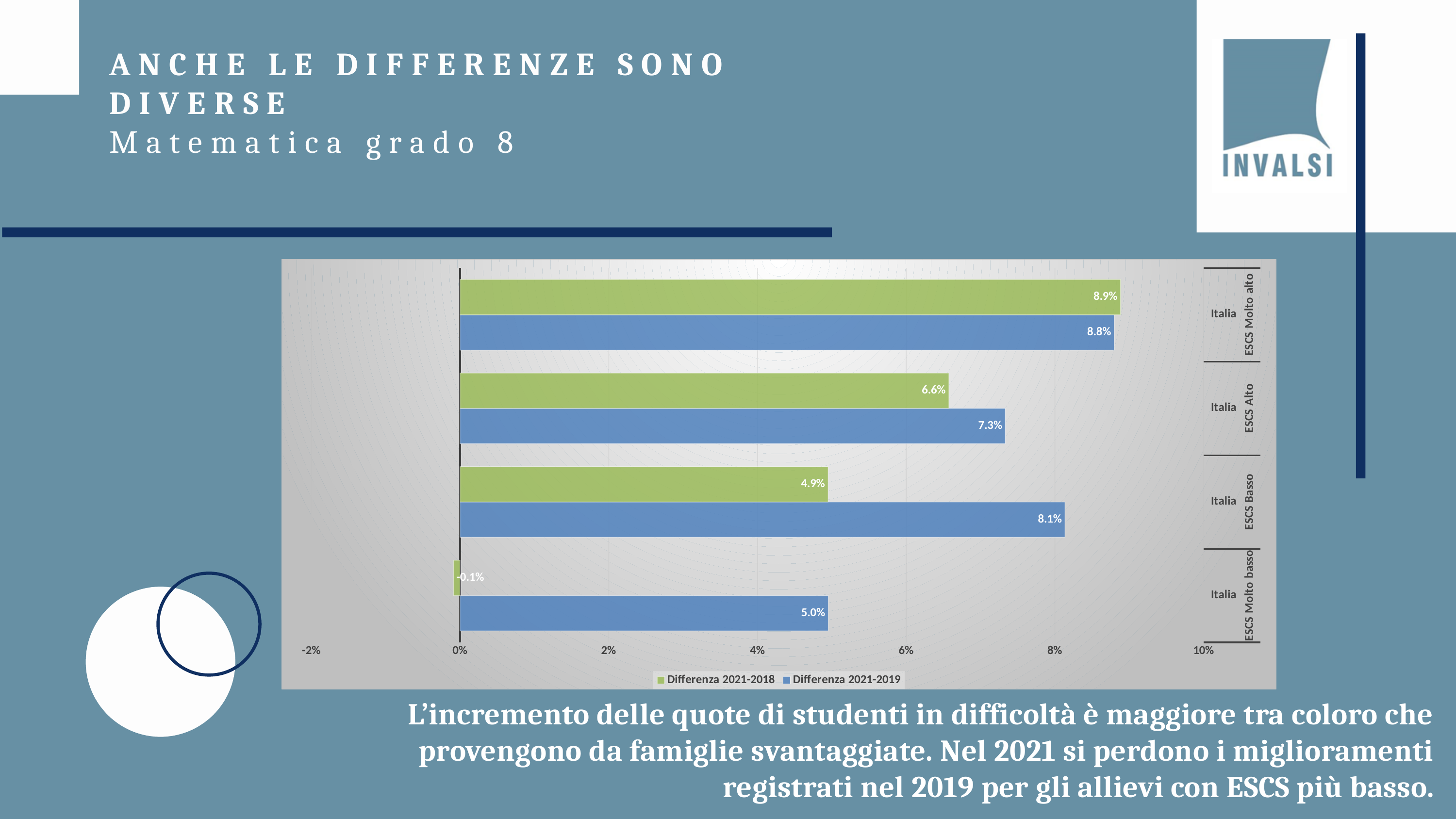
Which category has the highest value for Differenza 2021-2019? Italia ESCS Molto alto What is the value of Differenza 2021-2019 for Italia ESCS Basso? 8.1% What kind of chart is shown on the slide? Bar chart For Italia ESCS Alto, which series has the larger value: Differenza 2021-2018 or Differenza 2021-2019? Differenza 2021-2019 How many series does the legend list? 2 What is the difference between Differenza 2021-2019 and Differenza 2021-2018 for Italia ESCS Basso? 3.2% Which colour represents the series Differenza 2021-2019? Blue What is the value of Differenza 2021-2018 for Italia ESCS Molto basso? -0.1% Which category has the lowest value for Differenza 2021-2018? Italia ESCS Molto basso How many categories are shown on the chart? 4 What is the value of Differenza 2021-2019 for Italia ESCS Alto? 7.3% What is the value of Differenza 2021-2018 for Italia ESCS Molto alto? 8.9%